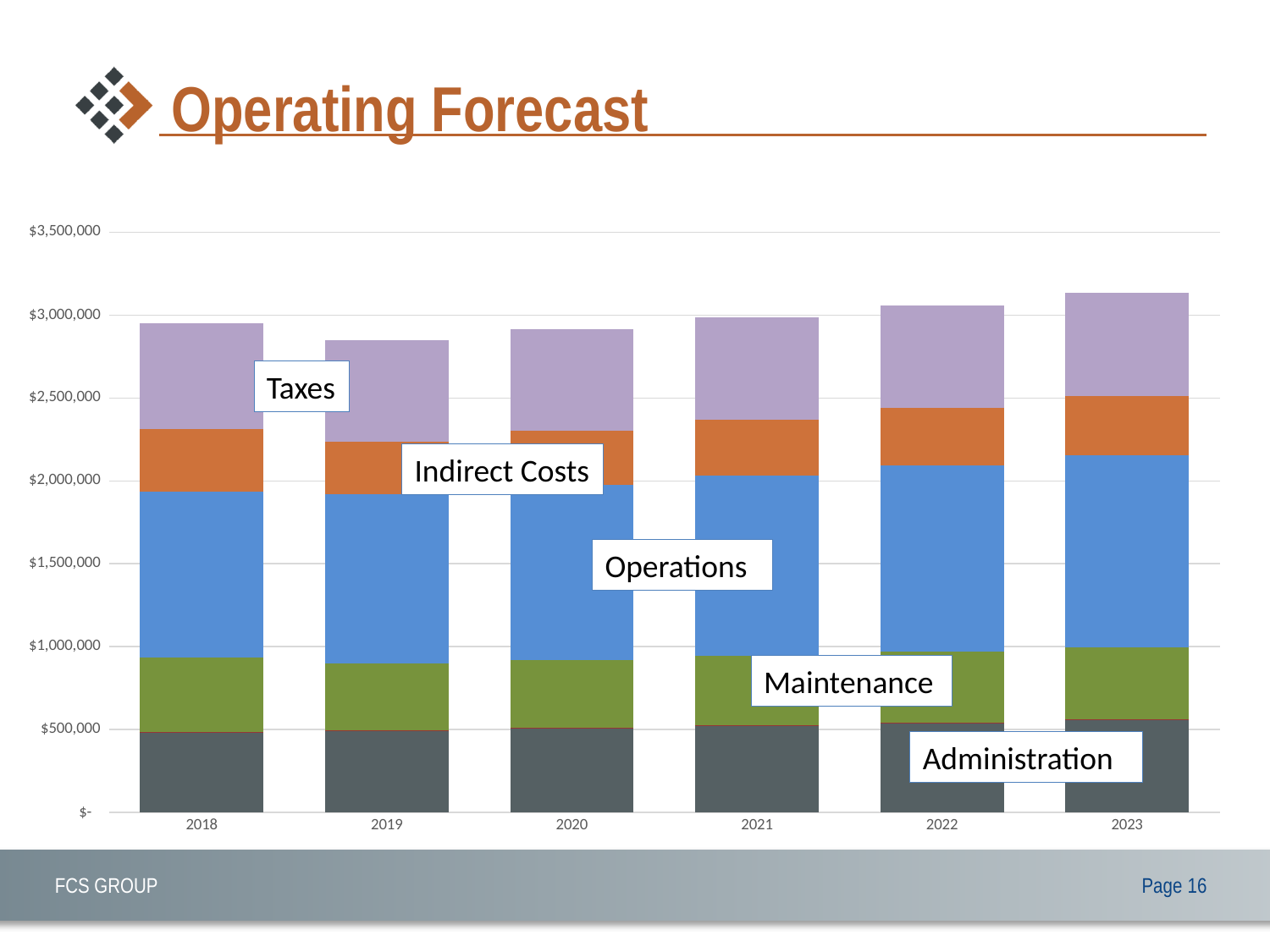
Is the total for 2019 greater or less than $3,000,000? less How many years are shown on the x axis of the chart? 6 Which cost category forms the largest segment of each bar? Operations What kind of chart is shown on the slide? Stacked bar chart Which year has the lowest total operating cost in the chart? 2019 Do the total operating costs rise or fall from 2019 to 2023? rise Is the total for 2023 greater or less than $3,000,000? greater Which is larger, the total for 2018 or the total for 2019? 2018 Which year has the highest total operating cost in the chart? 2023 Which cost category is at the top of each stacked bar? Taxes Which is larger, the total for 2022 or the total for 2020? 2022 Is the total for 2018 greater or less than $3,000,000? less